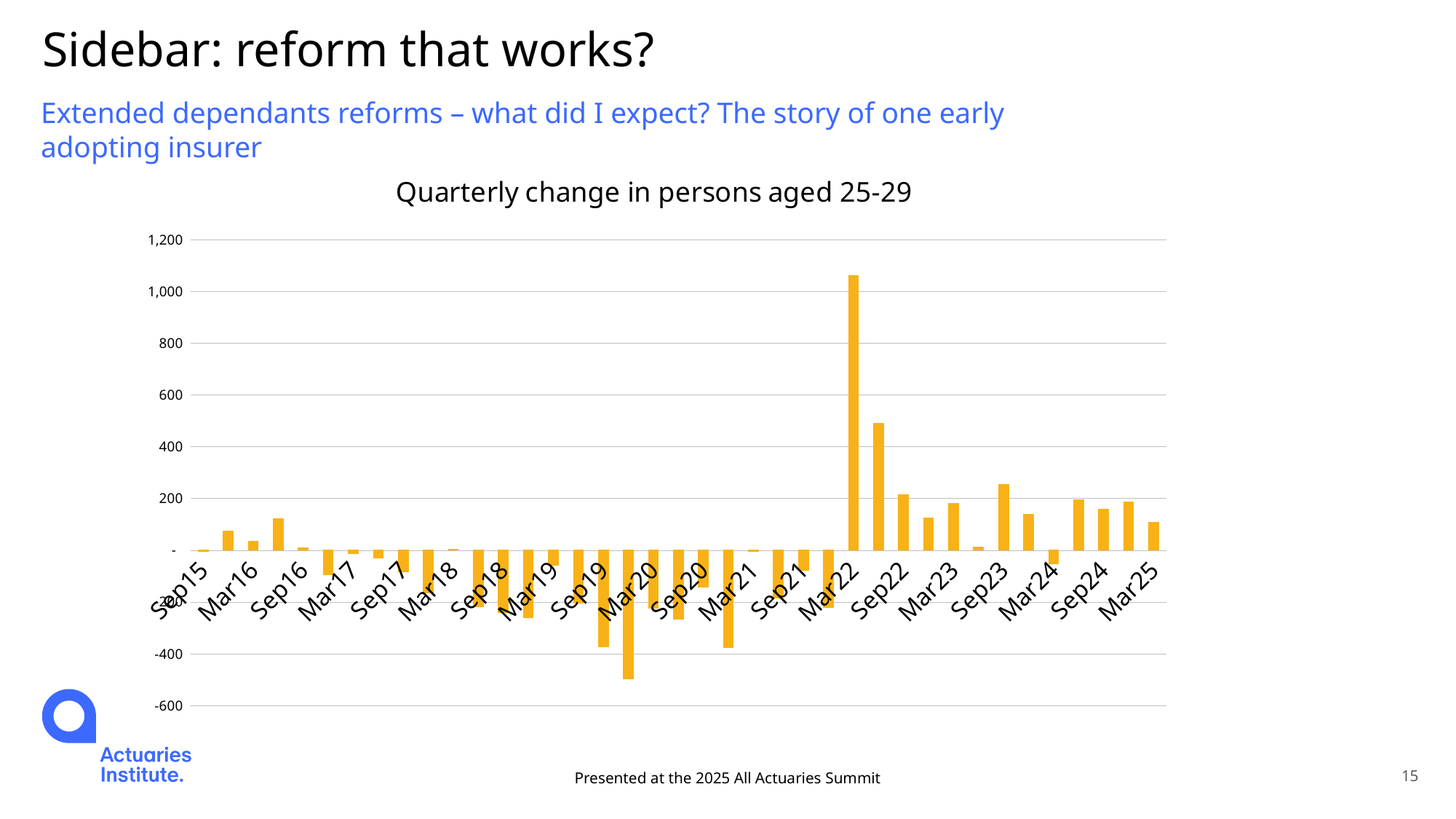
Is the value for Mar25 greater or less than 200? less Is the value for Sep23 greater or less than 200? greater Is the value for Mar22 greater or less than 1,000? greater What kind of chart is shown on the slide? Bar chart What is the title of the chart? Quarterly change in persons aged 25-29 Which quarter has the lowest value in the chart? Dec19 Which quarter has the highest value in the chart? Mar22 Between Sep17 and Sep21, are the quarterly changes mostly positive or negative? Negative Which is larger, the value for Mar16 or the value for Sep16? Mar16 Which is larger, the value for Mar22 or the value for Sep22? Mar22